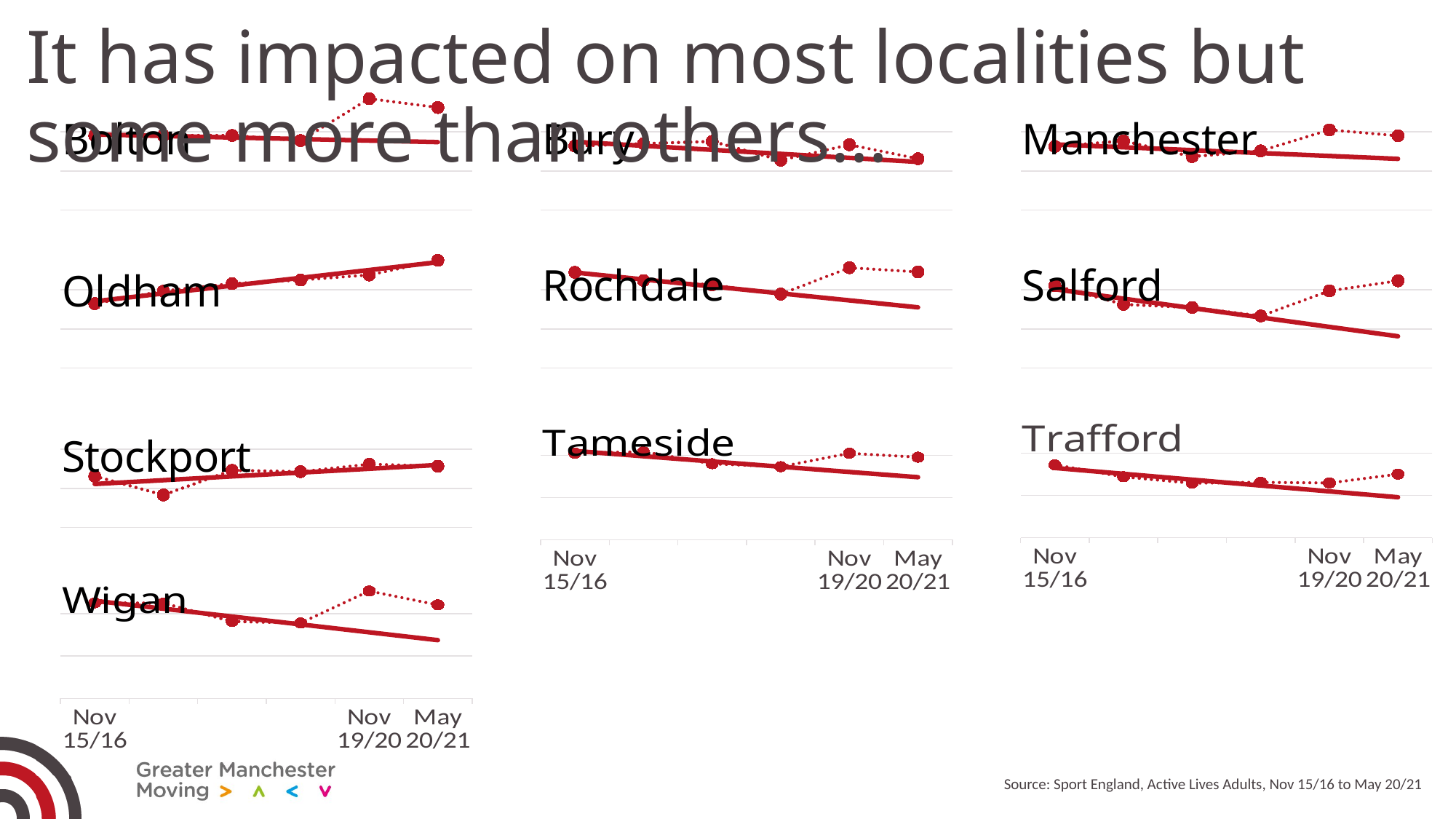
How many locality charts are shown on the slide? 10 What is the first x-axis label shown on the Wigan chart? Nov 15/16 What kind of chart is used for each locality on the slide? line chart How many data points are plotted in the Oldham chart? 6 In the Stockport chart, does the solid trend line rise or fall across the x axis? rise In the Bury chart, is the May 20/21 point higher or lower than the Nov 15/16 point? lower What is the last x-axis label shown on the Trafford chart? May 20/21 In the Salford chart, does the solid trend line rise or fall across the x axis? fall In the Oldham chart, is the May 20/21 point higher or lower than the Nov 15/16 point? higher In the Oldham chart, does the solid trend line rise or fall from Nov 15/16 to May 20/21? rise